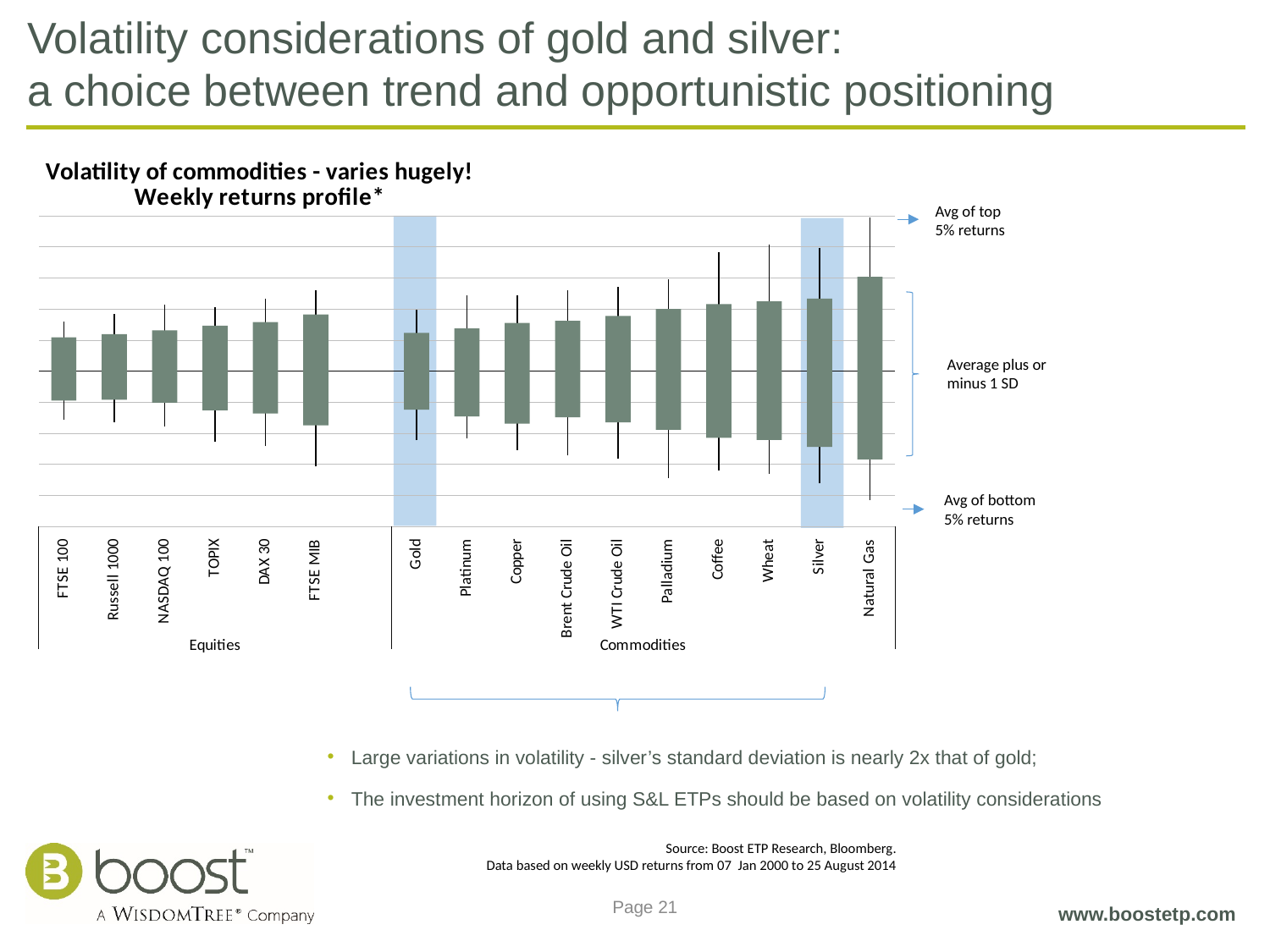
How many categories are in the Commodities group of the chart? 10 Which has the wider bar in the chart, Gold or Silver? Silver What kind of chart is shown on the slide? stock chart Which category's top whisker (avg of top 5% returns) reaches highest in the chart? Natural Gas What is the title of the chart? Volatility of commodities - varies hugely! Weekly returns profile* Which category has the widest bar (largest average plus or minus 1 SD range) in the chart? Natural Gas Moving left to right across the Commodities group, do the bars generally widen or narrow? widen Which category in the Equities group has the widest bar in the chart? FTSE MIB Which two categories are highlighted with blue shading in the chart? Gold and Silver Which has the wider bar in the chart, FTSE 100 or Natural Gas? Natural Gas How many categories are in the Equities group of the chart? 6 How many categories are plotted along the x axis of the chart? 16